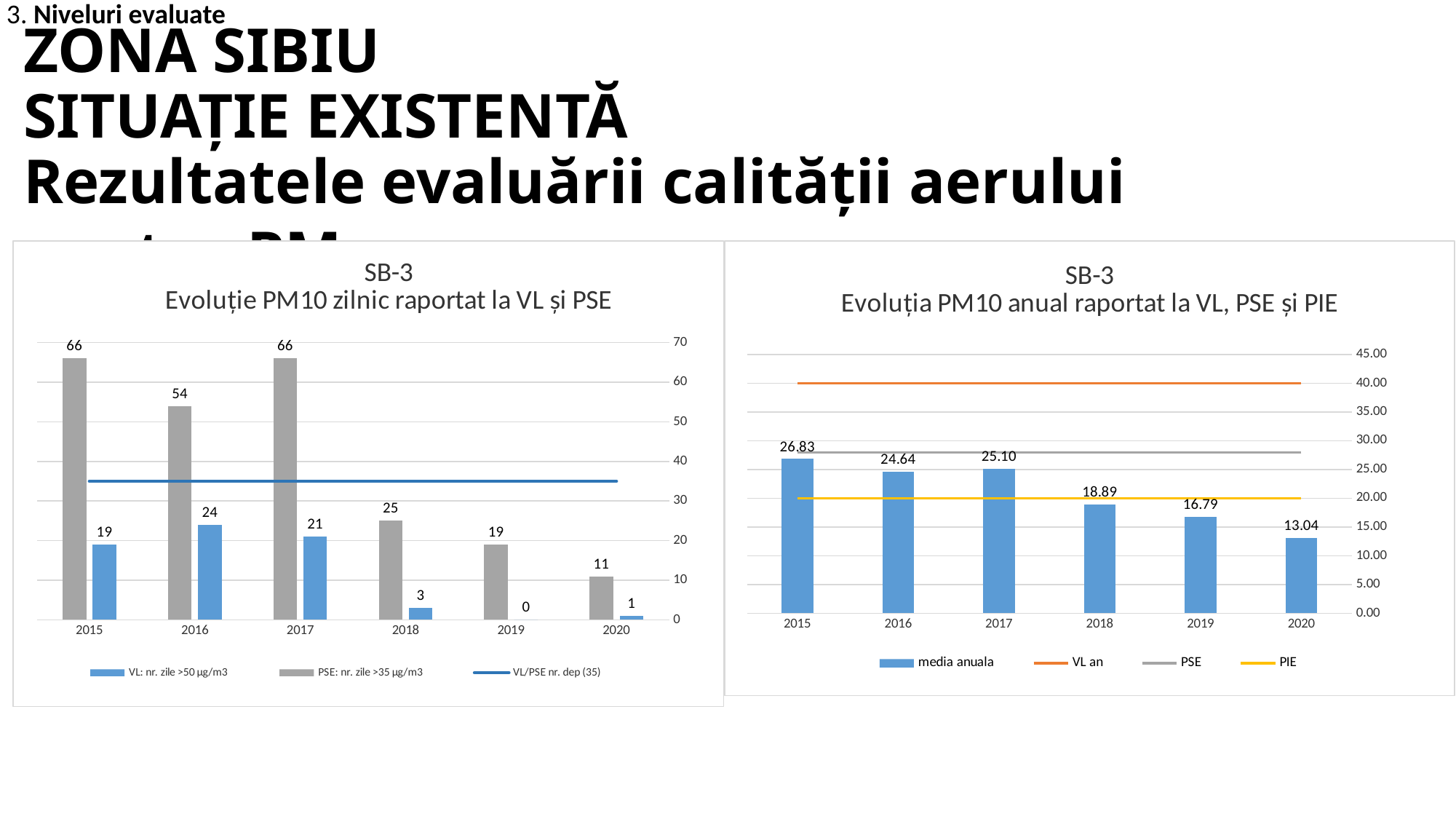
In the left chart (Evoluție PM10 zilnic raportat la VL și PSE), what is the difference between the 'PSE: nr. zile >35 µg/m3' values for 2017 and 2018? 41 In the left chart (Evoluție PM10 zilnic raportat la VL și PSE), how many series does the legend list? 3 In the right chart (Evoluția PM10 anual raportat la VL, PSE și PIE), how many years are shown on the x axis? 6 In the right chart (Evoluția PM10 anual raportat la VL, PSE și PIE), is the 'VL an' line greater or less than 35.00? greater In the right chart (Evoluția PM10 anual raportat la VL, PSE și PIE), what is the 'media anuala' value for 2017? 25.10 In the left chart (Evoluție PM10 zilnic raportat la VL și PSE), which year has the lowest value for 'VL: nr. zile >50 µg/m3'? 2019 In the right chart (Evoluția PM10 anual raportat la VL, PSE și PIE), does the 'media anuala' value generally rise or fall from 2017 to 2020? fall In the left chart (Evoluție PM10 zilnic raportat la VL și PSE), what is the value of 'VL: nr. zile >50 µg/m3' for 2018? 3 In the right chart (Evoluția PM10 anual raportat la VL, PSE și PIE), what is the difference between the 'media anuala' values for 2015 and 2020? 13.79 In the left chart (Evoluție PM10 zilnic raportat la VL și PSE), what is the value of 'PSE: nr. zile >35 µg/m3' for 2016? 54 In the left chart (Evoluție PM10 zilnic raportat la VL și PSE), is the 'PSE: nr. zile >35 µg/m3' value for 2019 greater or less than the 'VL: nr. zile >50 µg/m3' value for 2016? less In the right chart (Evoluția PM10 anual raportat la VL, PSE și PIE), which year has the highest 'media anuala' value? 2015